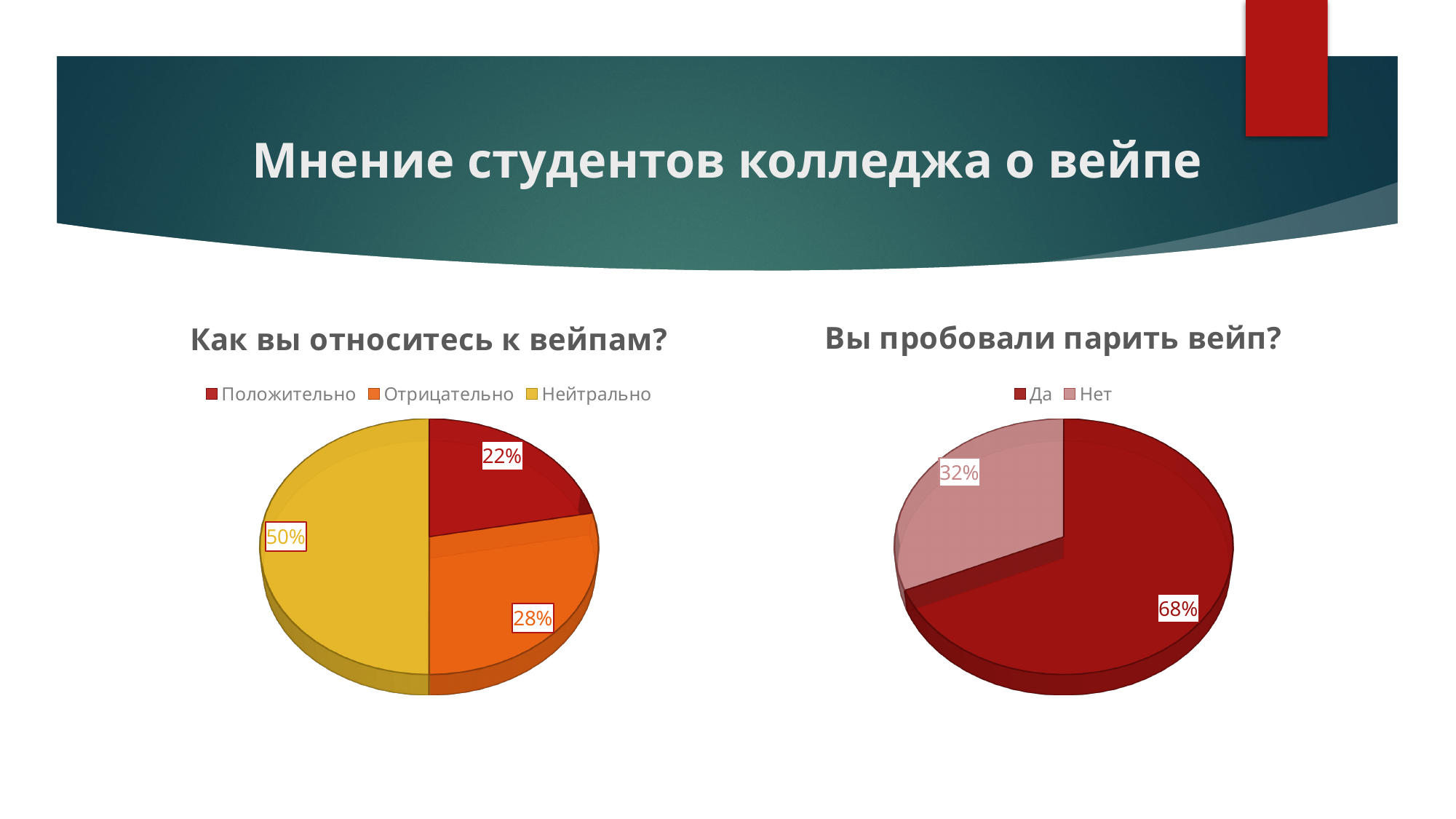
In the chart titled "Вы пробовали парить вейп?", what is the difference between the Да and Нет shares? 36% In the chart titled "Вы пробовали парить вейп?", what share is labelled for Да? 68% What kind of chart is the chart titled "Вы пробовали парить вейп?"? Pie chart In the chart titled "Как вы относитесь к вейпам?", how many categories does the legend list? 3 In the chart titled "Вы пробовали парить вейп?", what share is labelled for Нет? 32% In the chart titled "Вы пробовали парить вейп?", which is larger, Да or Нет? Да In the chart titled "Как вы относитесь к вейпам?", what share is labelled for Отрицательно? 28% In the chart titled "Как вы относитесь к вейпам?", what share is labelled for Нейтрально? 50% In the chart titled "Как вы относитесь к вейпам?", which category has the smallest slice? Положительно In the chart titled "Как вы относитесь к вейпам?", what share is labelled for Положительно? 22% In the chart titled "Как вы относитесь к вейпам?", which category has the largest slice? Нейтрально In the chart titled "Как вы относитесь к вейпам?", what is the difference between the Нейтрально and Отрицательно shares? 22%